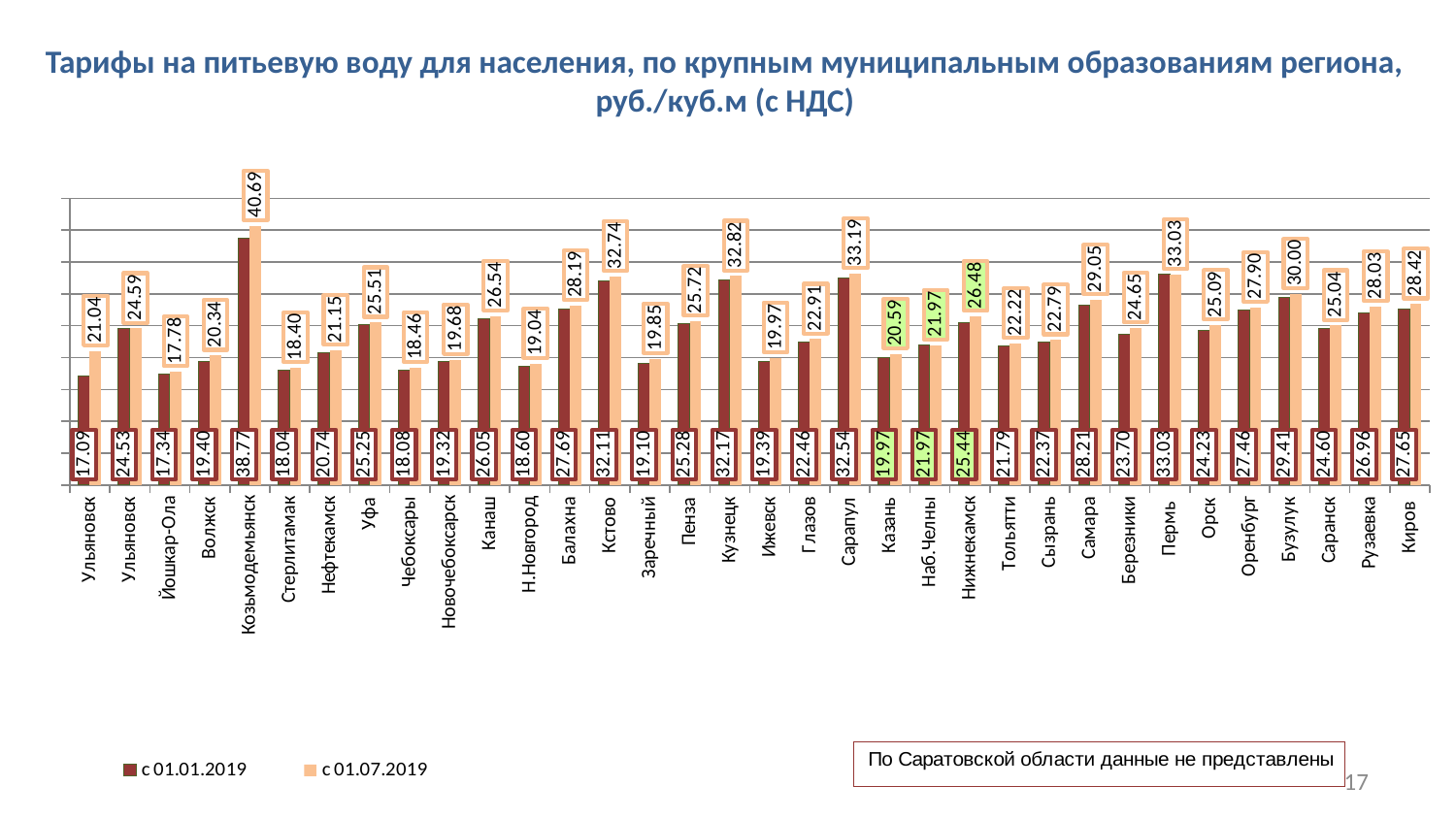
How many series does the legend list? 2 How many municipalities (categories) are shown on the x axis? 34 Which municipality has the lowest tariff in the 'с 01.07.2019' series? Йошкар-Ола What is the difference between the 'с 01.07.2019' and 'с 01.01.2019' values for Козьмодемьянск? 1.92 What are the two series named in the legend? с 01.01.2019 and с 01.07.2019 What kind of chart is shown on the slide? bar chart What is the tariff for Козьмодемьянск in the 'с 01.07.2019' series? 40.69 What is the difference between the 'с 01.07.2019' and 'с 01.01.2019' values for Нижнекамск? 1.04 Which municipality has the highest tariff in the 'с 01.07.2019' series? Козьмодемьянск Which is larger in the 'с 01.07.2019' series: Пермь or Бузулук? Пермь What is the tariff for Самара in the 'с 01.01.2019' series? 28.21 What is the tariff for Казань in the 'с 01.07.2019' series? 20.59